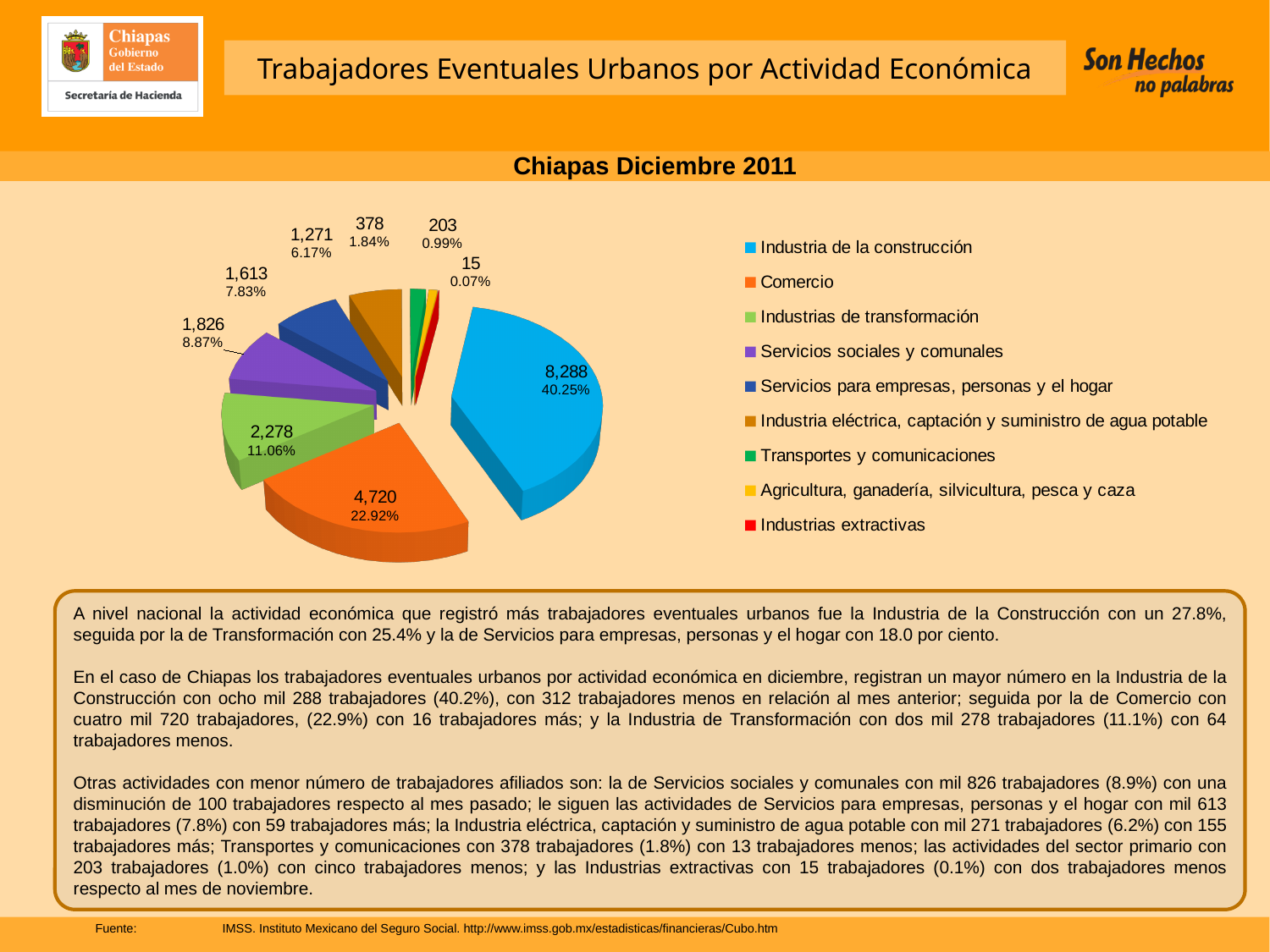
What kind of chart is shown on the slide? Pie chart What is the value shown for Comercio? 4,720 What percentage share does the Comercio slice have? 22.92% Which category has the smallest slice of the pie? Industrias extractivas Which is larger, the value for Servicios sociales y comunales or the value for Servicios para empresas, personas y el hogar? Servicios sociales y comunales What is the value shown for Industria de la construcción? 8,288 How many categories does the legend of the pie chart list? 9 What percentage share does the Industria de la construcción slice have? 40.25% What is the difference between the values for Industria de la construcción and Comercio? 3,568 Which category has the largest slice of the pie? Industria de la construcción What is the title shown above the pie chart? Chiapas Diciembre 2011 What is the value shown for Industrias de transformación? 2,278